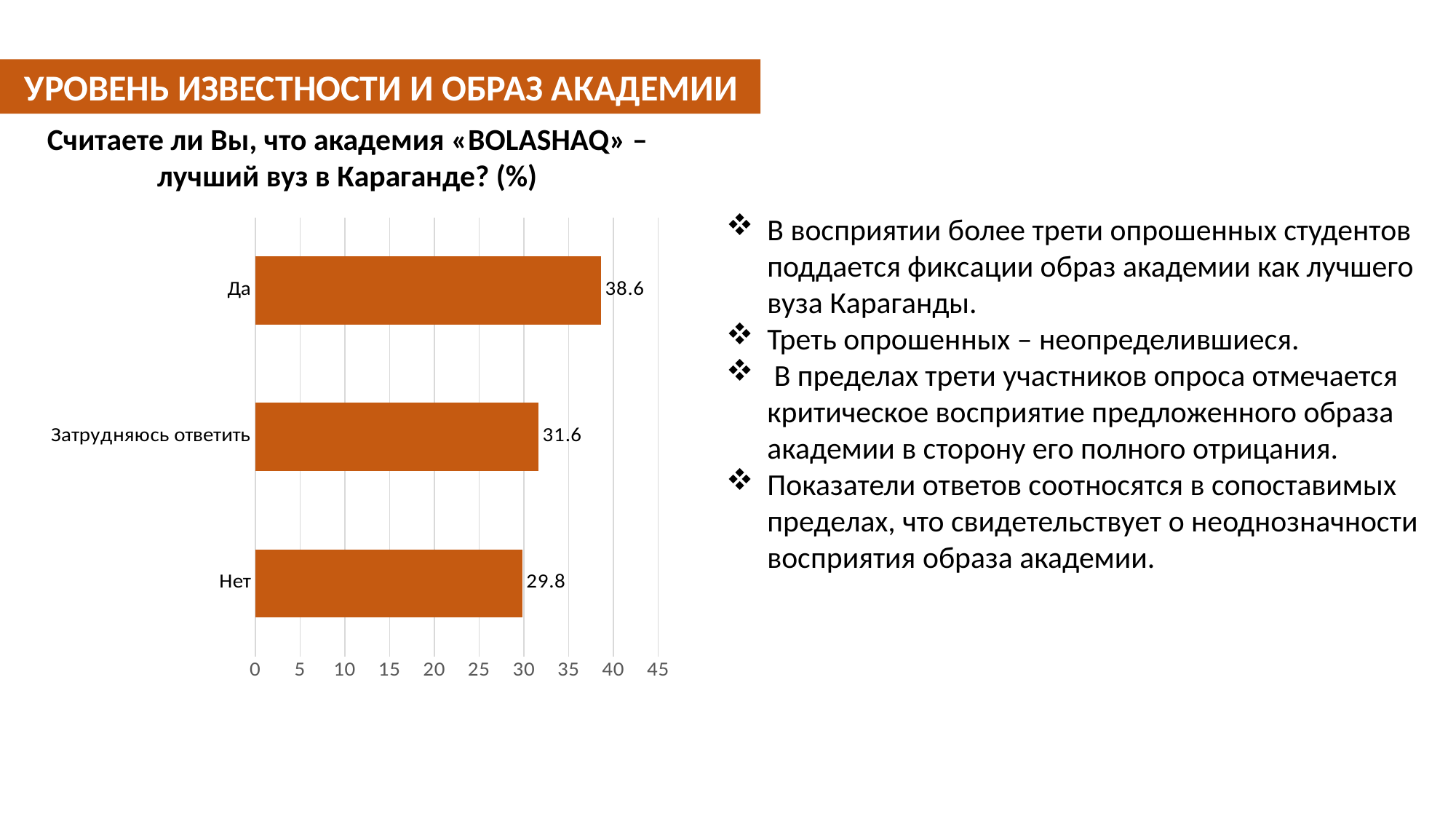
What is the value for "Да"? 38.6 What kind of chart is shown on the slide? bar chart Which category has the highest value? Да What is the value for "Затрудняюсь ответить"? 31.6 What is the difference between the values for "Затрудняюсь ответить" and "Нет"? 1.8 What is the difference between the values for "Да" and "Нет"? 8.8 Is the value for "Нет" greater or less than 30? less What is the value for "Нет"? 29.8 What is the title of the chart? Считаете ли Вы, что академия «BOLASHAQ» – лучший вуз в Караганде? (%) How many categories are shown in the chart? 3 Which category has the lowest value? Нет Which is larger, the value for "Да" or the value for "Затрудняюсь ответить"? Да